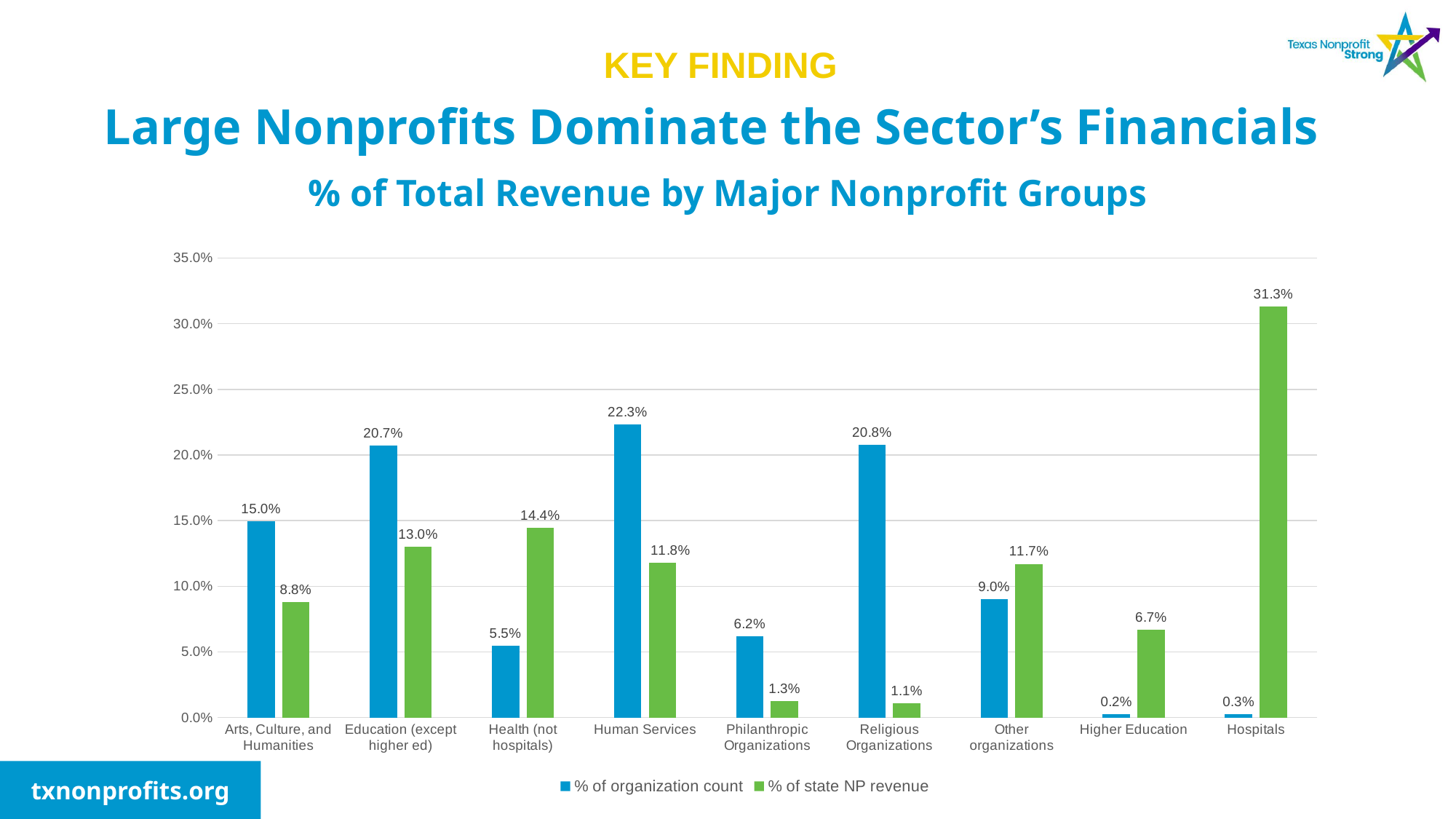
What is the % of state NP revenue for Health (not hospitals)? 14.4% Which category has the highest % of state NP revenue? Hospitals What is the % of organization count for Human Services? 22.3% How many nonprofit groups are shown on the x axis? 9 How many series does the legend list? 2 Which category has the lowest % of organization count? Higher Education What is the difference between the % of organization count and the % of state NP revenue for Religious Organizations? 19.7% What is the % of state NP revenue for Hospitals? 31.3% What kind of chart is shown on the slide? Bar chart What is the % of organization count for Philanthropic Organizations? 6.2% Which is larger for Education (except higher ed): the % of organization count or the % of state NP revenue? % of organization count What colour are the bars for % of state NP revenue? Green